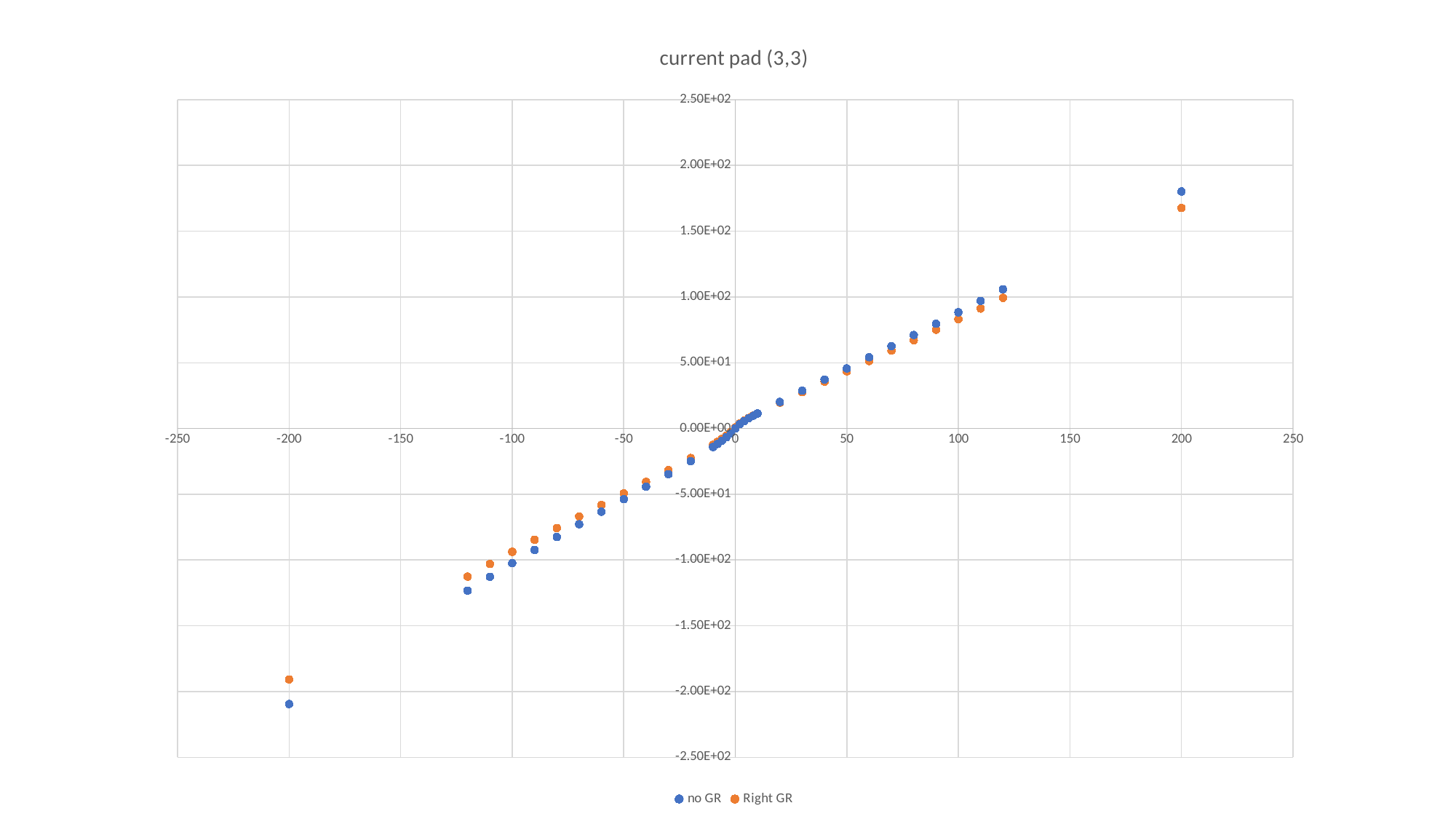
What is the title of the chart? current pad (3,3) Is the value for no GR at x = 100 greater or less than 5.00E+01? greater What kind of chart is shown on the slide? scatter chart At x = 200, which series has the higher value, no GR or Right GR? no GR Is the value for no GR at x = 120 greater or less than 1.00E+02? greater Is the value for no GR at x = 200 greater or less than 1.50E+02? greater At x = -200, which series has the lower value, no GR or Right GR? no GR Which series is plotted in orange? Right GR Do the values for the no GR series rise or fall as x increases from -200 to 200? rise How many series does the legend list? 2